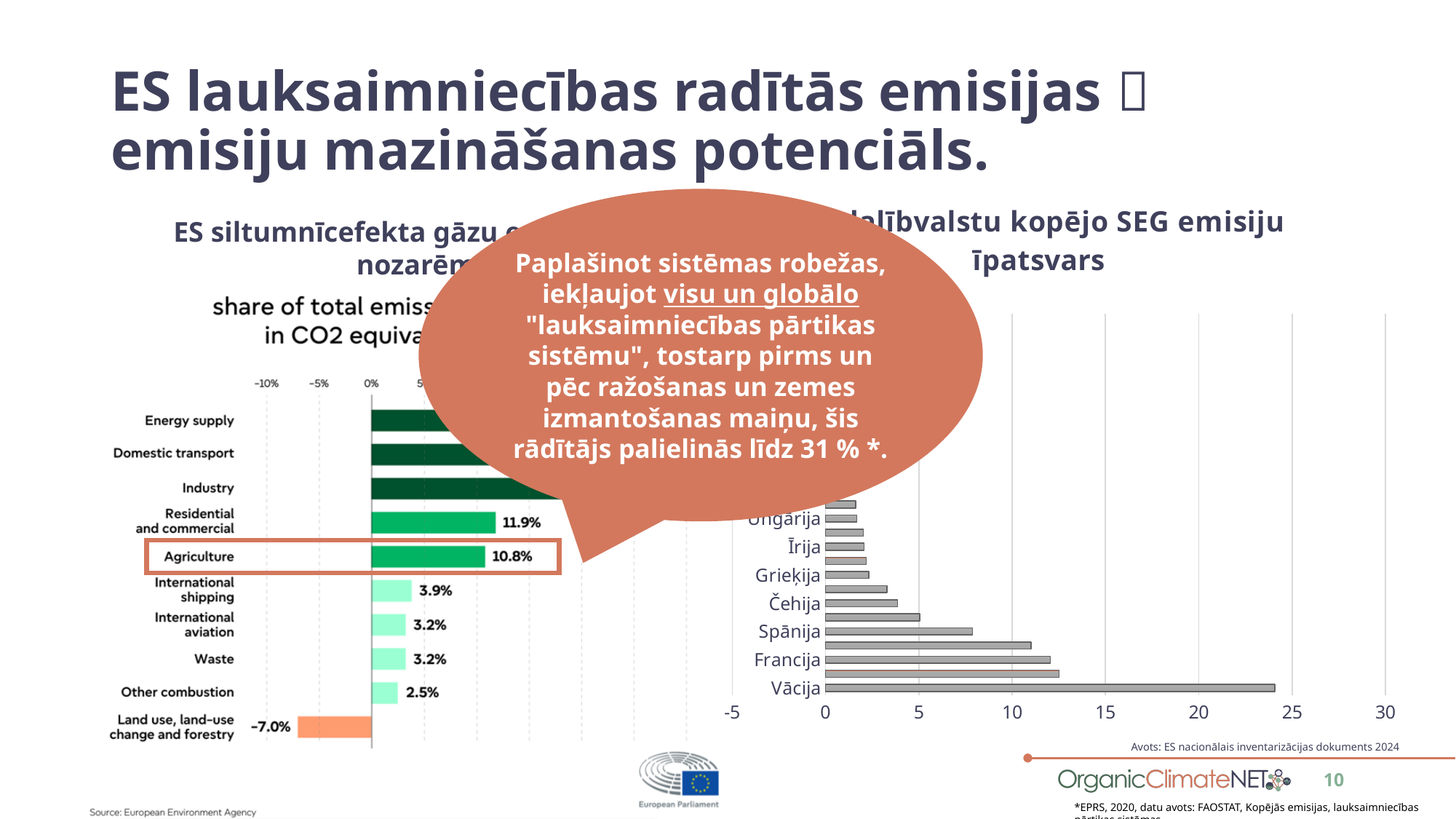
In the left chart (share of total emissions in CO2 equivalent), what is the value for Residential and commercial? 11.9% In the right chart (member states' share of total GHG emissions), is the value for Čehija greater or less than 5? less In the left chart (share of total emissions in CO2 equivalent), which category has the lowest value? Land use, land-use change and forestry What kind of chart is the right chart (member states' share of total GHG emissions)? Bar chart In the left chart (share of total emissions in CO2 equivalent), which is larger: International shipping or Waste? International shipping In the left chart (share of total emissions in CO2 equivalent), how many sector categories are listed? 10 In the right chart (member states' share of total GHG emissions), is the value for Vācija greater or less than 20? greater In the left chart (share of total emissions in CO2 equivalent), what is the difference between Residential and commercial and Agriculture? 1.1% In the left chart (share of total emissions in CO2 equivalent), what is the value for Other combustion? 2.5% In the left chart (share of total emissions in CO2 equivalent), what is the value for Land use, land-use change and forestry? -7.0% In the left chart (share of total emissions in CO2 equivalent), what is the value for Agriculture? 10.8% In the left chart (share of total emissions in CO2 equivalent), what is the value for International shipping? 3.9%